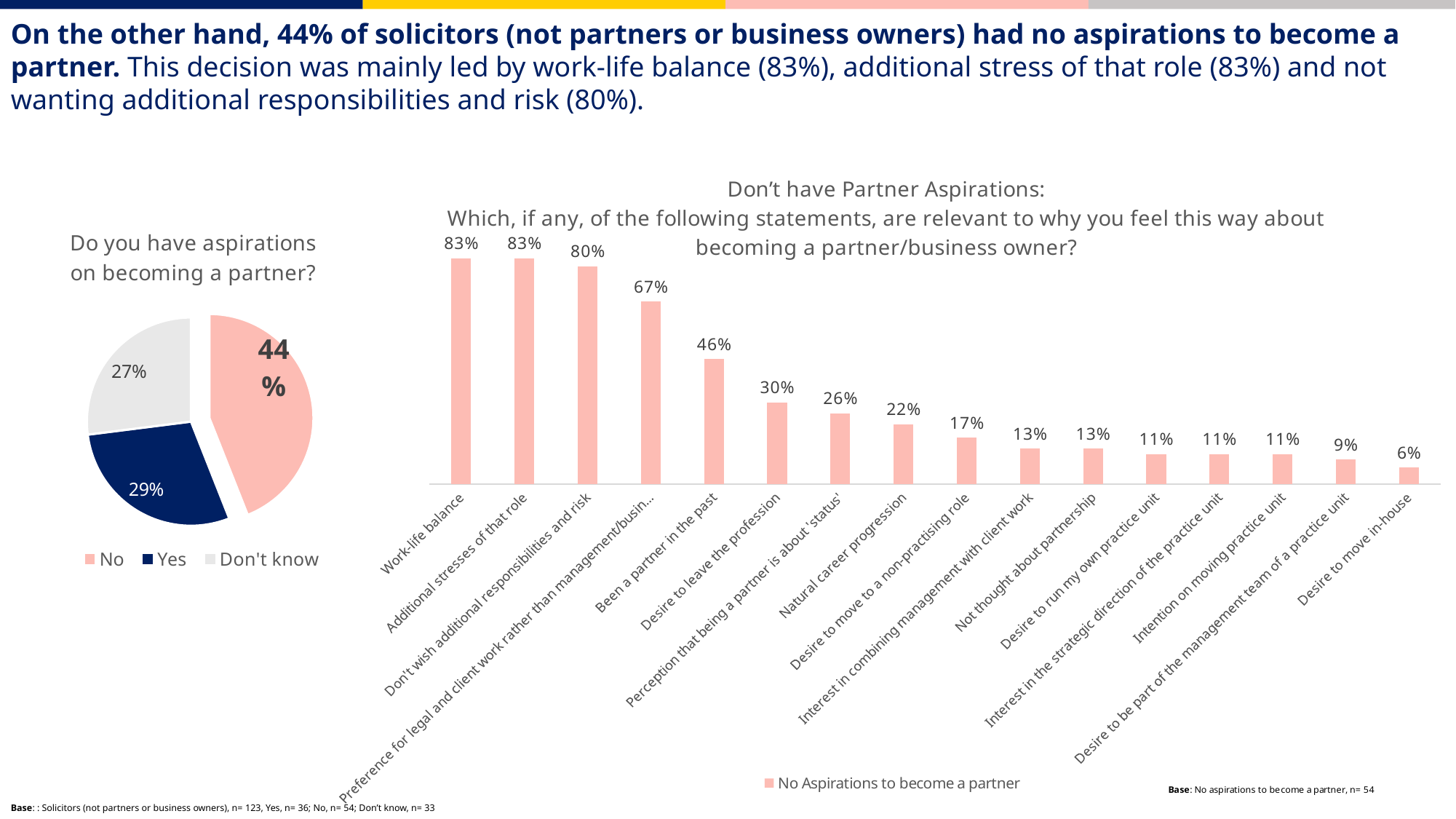
What type of chart is the chart on the right of the slide? Bar chart In the bar chart 'Don't have Partner Aspirations', which is larger: 'Perception that being a partner is about 'status'' or 'Desire to move to a non-practising role'? Perception that being a partner is about 'status' In the bar chart 'Don't have Partner Aspirations', what is the value for 'Desire to leave the profession'? 30% In the pie chart 'Do you have aspirations on becoming a partner?', how many slices are there? 3 In the pie chart 'Do you have aspirations on becoming a partner?', what share of respondents answered 'No'? 44% In the bar chart 'Don't have Partner Aspirations', what is the value for 'Been a partner in the past'? 46% In the pie chart 'Do you have aspirations on becoming a partner?', what share of respondents answered 'Don't know'? 27% In the bar chart 'Don't have Partner Aspirations', which statement has the lowest value? Desire to move in-house In the bar chart 'Don't have Partner Aspirations', do the values rise or fall from left to right? Fall In the pie chart 'Do you have aspirations on becoming a partner?', what share of respondents answered 'Yes'? 29% In the bar chart 'Don't have Partner Aspirations', what is the difference between 'Work-life balance' and 'Natural career progression'? 61% In the pie chart 'Do you have aspirations on becoming a partner?', which response has the largest share? No